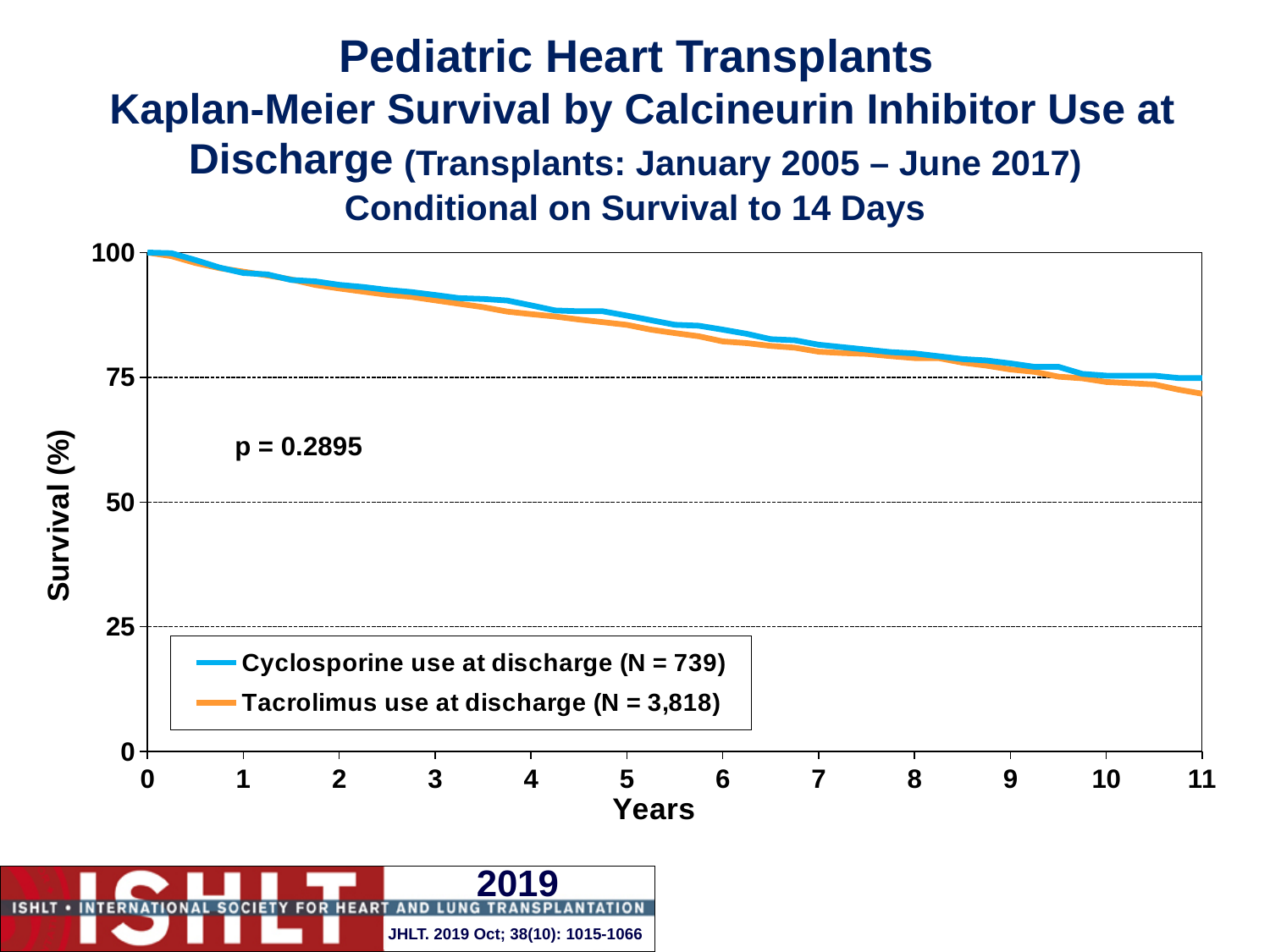
What is the N shown in the legend for Cyclosporine use at discharge? 739 What kind of chart is shown on the slide? Line chart At 3 years, which series has the higher survival: Cyclosporine use at discharge or Tacrolimus use at discharge? Cyclosporine use at discharge Is the survival value for Tacrolimus use at discharge at 11 years greater or less than 75? less At 11 years, which series has the higher survival: Cyclosporine use at discharge or Tacrolimus use at discharge? Cyclosporine use at discharge Is the survival value for Cyclosporine use at discharge at 8 years greater or less than 50? greater Is the survival value for Tacrolimus use at discharge at 1 year greater or less than 75? greater What p-value is printed on the chart? p = 0.2895 Do the survival curves rise or fall as years since transplant increase? Fall How many series does the legend list? 2